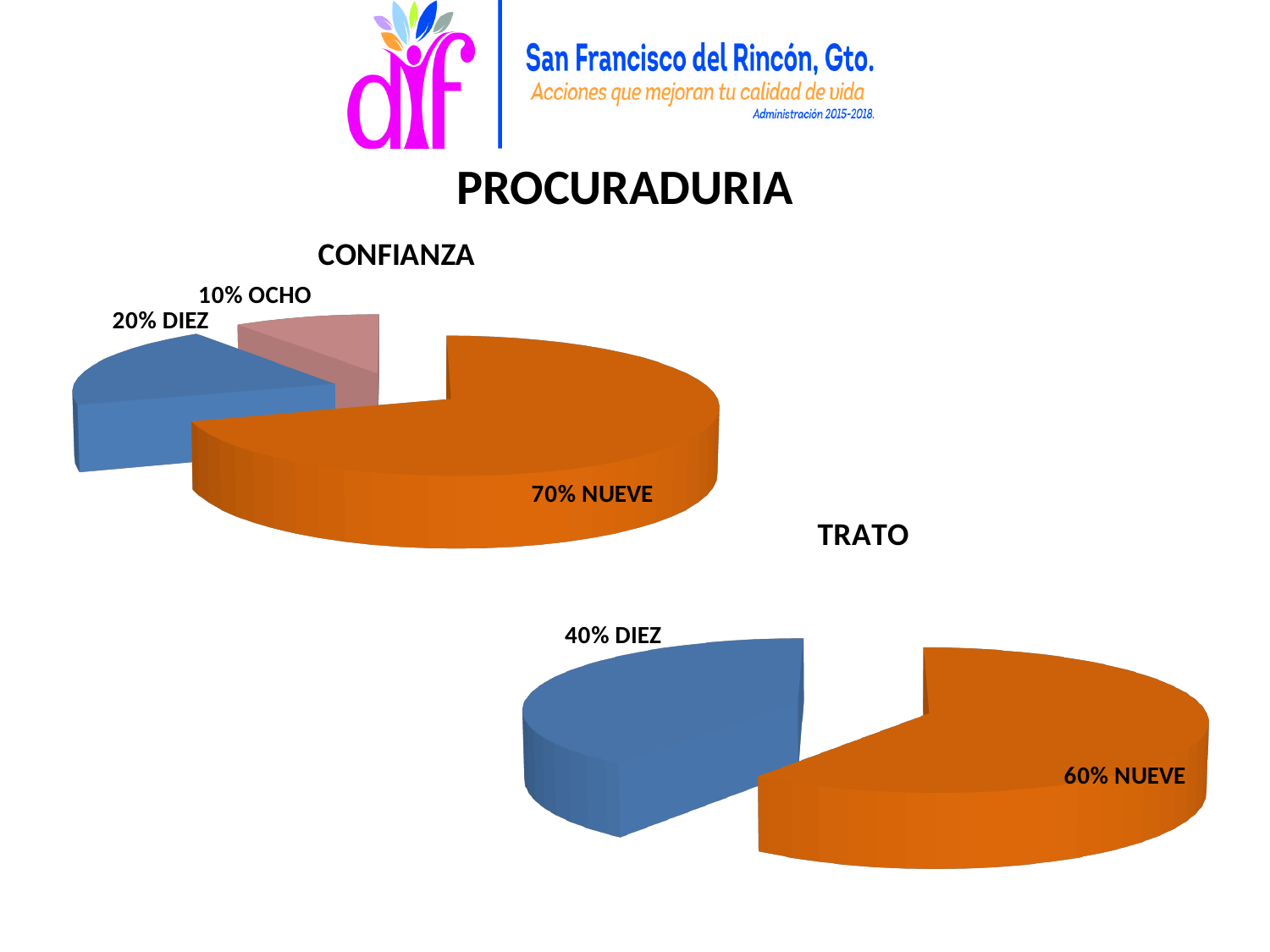
In the TRATO chart, how many slices does the pie have? 2 In the CONFIANZA chart, which category has the largest slice? NUEVE In the TRATO chart, which slice is larger, DIEZ or NUEVE? NUEVE In the CONFIANZA chart, what share of the pie is labelled NUEVE? 70% In the CONFIANZA chart, which category has the smallest slice? OCHO In the TRATO chart, what share of the pie is labelled DIEZ? 40% In the CONFIANZA chart, what share of the pie is labelled OCHO? 10% In the CONFIANZA chart, what is the difference in percentage points between the NUEVE slice and the DIEZ slice? 50 In the CONFIANZA chart, how many slices does the pie have? 3 What kind of chart is the TRATO chart? Pie chart